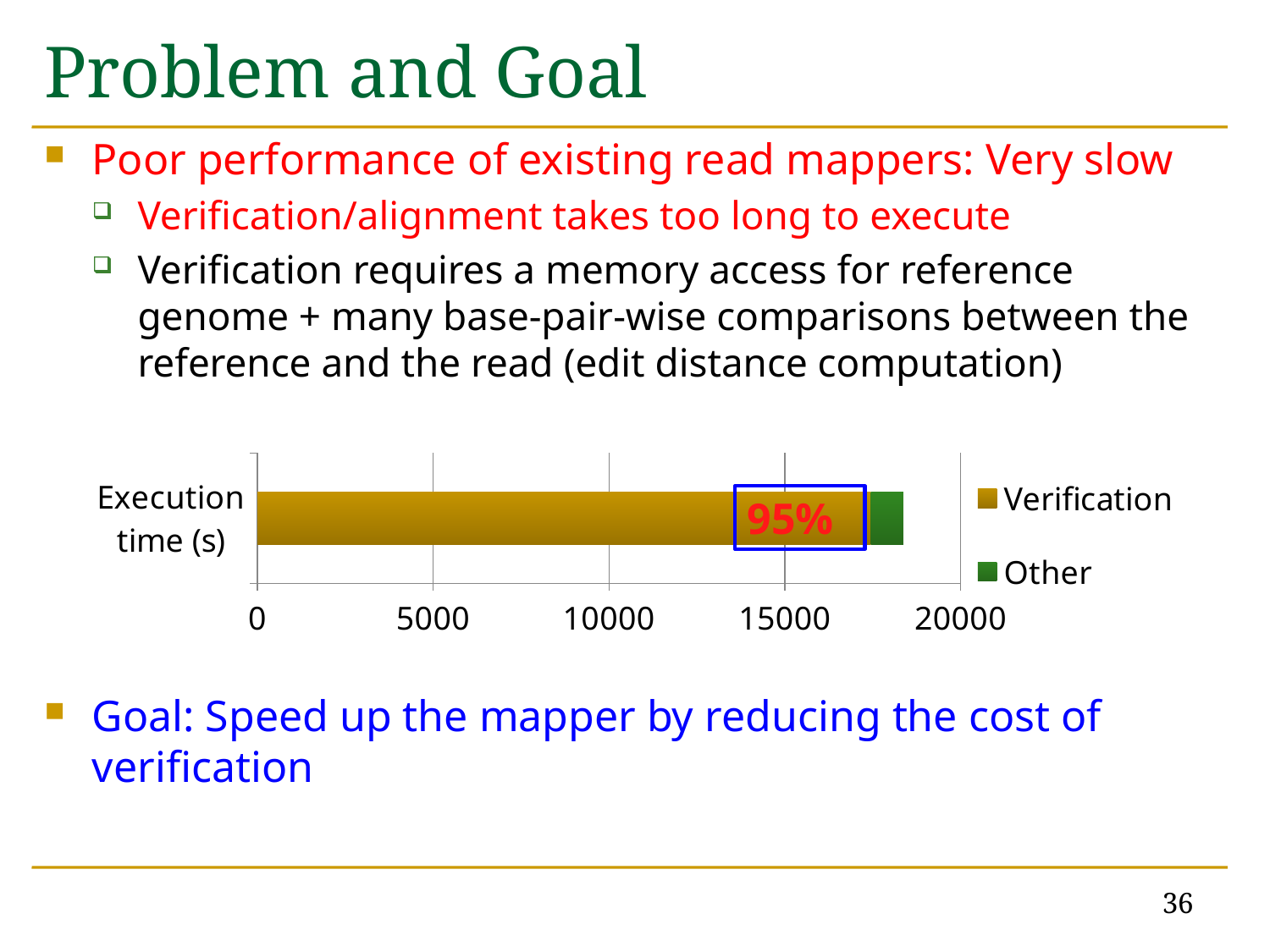
What percentage label is printed on the Verification segment of the bar? 95% How many series does the chart's legend list? 2 Which series has the smallest share of the Execution time bar? Other Is the Other portion of the Execution time bar greater or less than 5000? less What kind of chart is shown on the slide? bar chart How many categories are plotted on the chart's vertical axis? 1 Which series takes up the larger part of the Execution time bar, Verification or Other? Verification Is the Verification portion of the Execution time bar greater or less than 15000? greater Is the total length of the Execution time bar greater or less than 20000? less What are the two series named in the chart's legend? Verification and Other What is the highest tick value shown on the chart's horizontal axis? 20000 What is the label of the single category on the chart's vertical axis? Execution time (s)